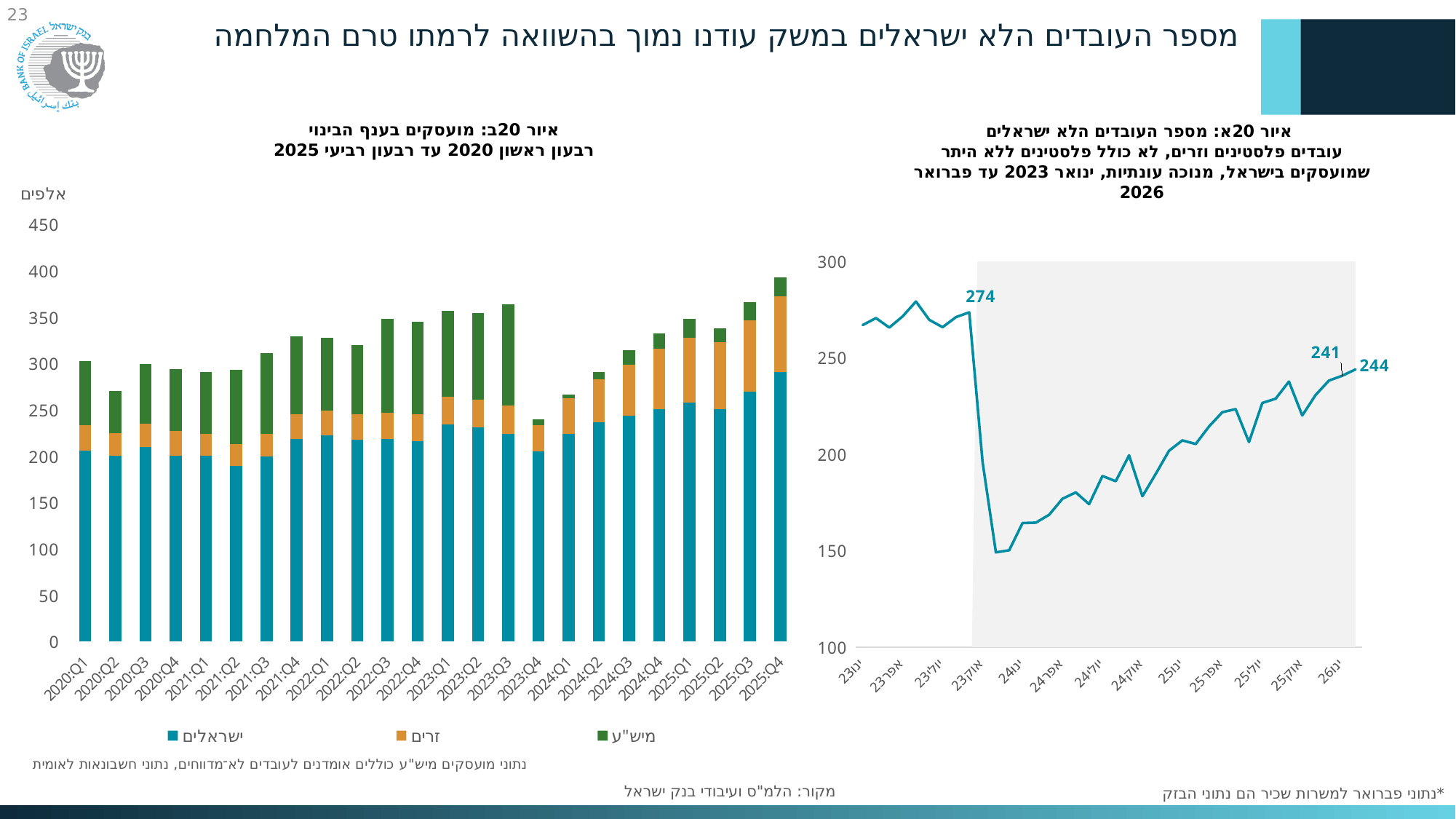
In the right chart (איור 20א), is the value around ינו-24 greater or less than 200? less In the right chart (איור 20א), what is the value labelled at the last point of the line (ינו-26)? 244 In the left chart (איור 20ב), is the total for 2023:Q4 greater or less than 250? less In the right chart (איור 20א), what value is labelled at the peak just before the sharp drop in late 2023? 274 In the right chart (איור 20א), is the value around ינו-25 greater or less than 200? greater What kind of chart is the right chart (איור 20א)? line chart How many series does the legend of the left chart (איור 20ב) list? 3 In the right chart (איור 20א), which labelled value is larger: 241 or 244? 244 In the left chart (איור 20ב), which quarter has the highest total stacked bar? 2025:Q4 What kind of chart is the left chart (איור 20ב)? bar chart How many quarters (bars) are shown in the left chart (איור 20ב)? 24 In the right chart (איור 20א), what is the difference between the labelled value 274 and the final labelled value 244? 30